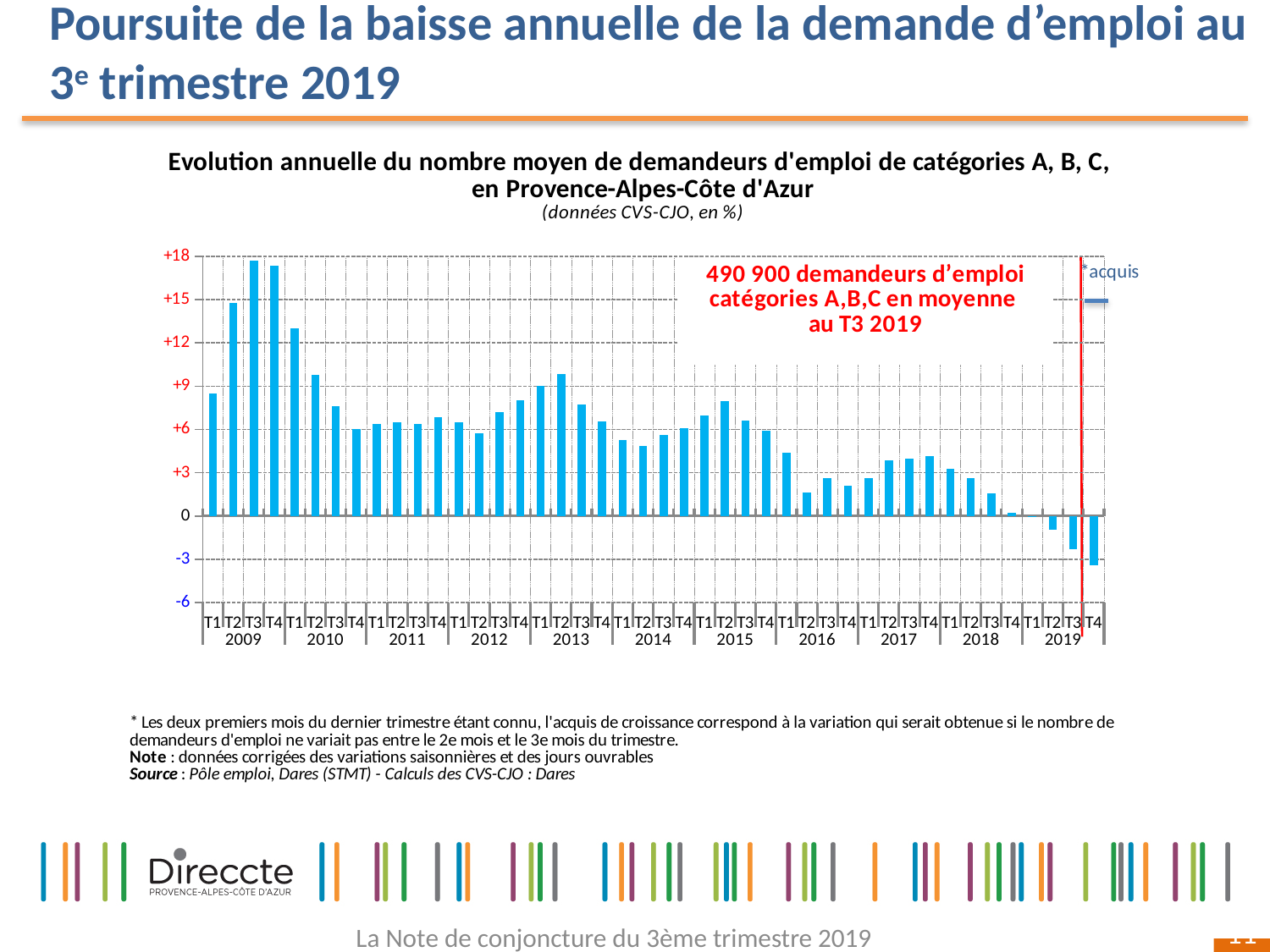
Is the value for T3 2010 greater or less than +9? less Is the value for T3 2019 greater or less than 0? less In which year does the highest bar of the chart appear? 2009 What kind of chart is shown on the slide? bar chart Which quarter has the lowest value in the chart? T4 2019 Which is larger, the value for T2 2009 or the value for T2 2010? T2 2009 Which is larger, the value for T1 2014 or the value for T1 2015? T1 2015 Overall, do the values rise or fall from 2009 to 2019? fall How many years are labelled along the x axis of the chart? 11 According to the red annotation on the chart, what was the average number of job seekers in categories A, B, C in T3 2019? 490 900 Is the value for T2 2009 greater or less than +12? greater